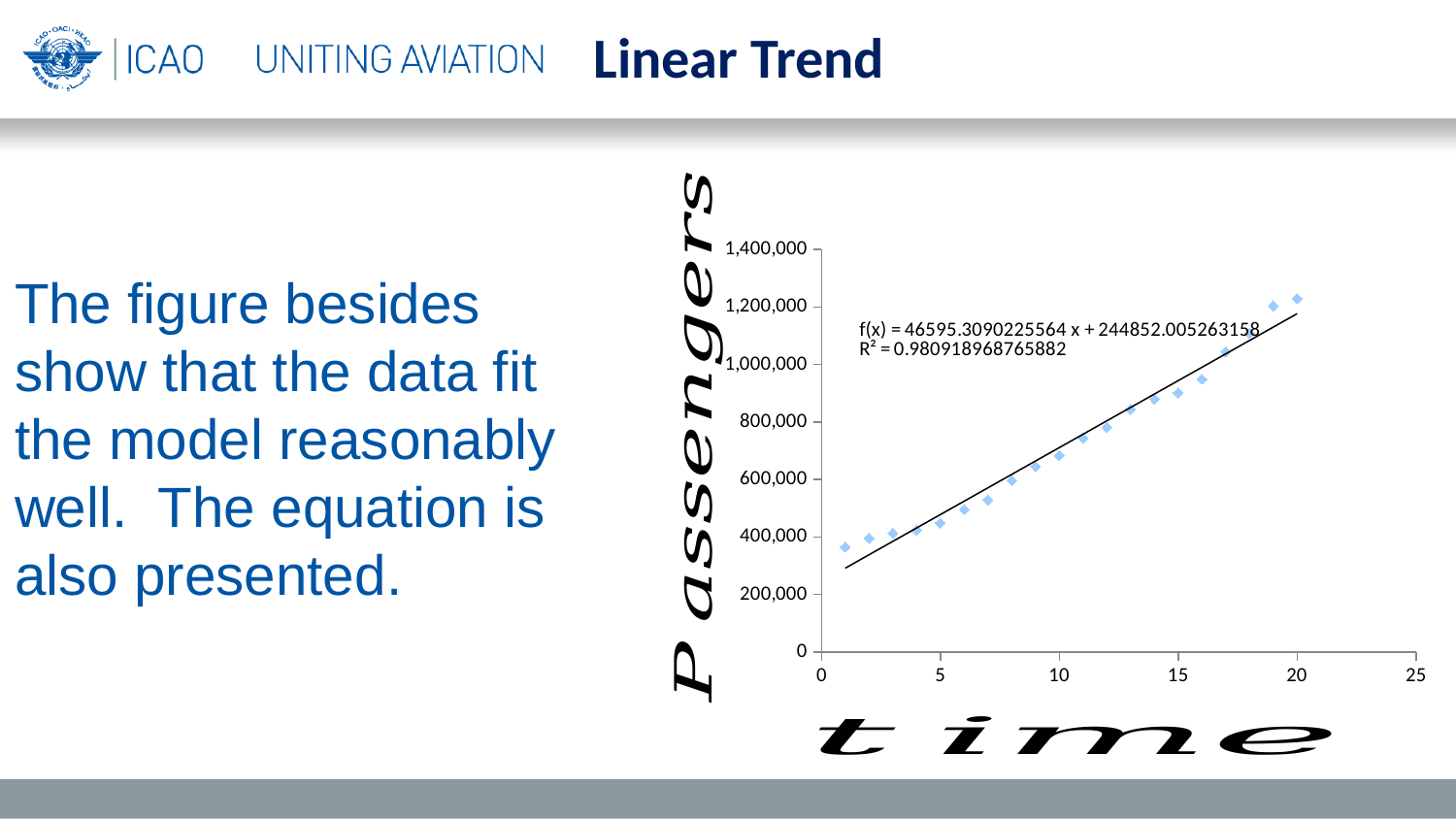
Do the plotted passenger values rise or fall as time increases along the x axis? rise Which has the larger passengers value, time 10 or time 5? time 10 Is the passengers value at time 1 greater or less than 400,000? less What is the label of the vertical axis of the chart? Passengers At which time value is the plotted passengers value highest? 20 Is the passengers value at time 5 greater or less than 600,000? less Is the passengers value at time 20 greater or less than 1,000,000? greater What is the label of the horizontal axis of the chart? time What kind of chart is shown on the slide? scatter chart At which time value is the plotted passengers value lowest? 1